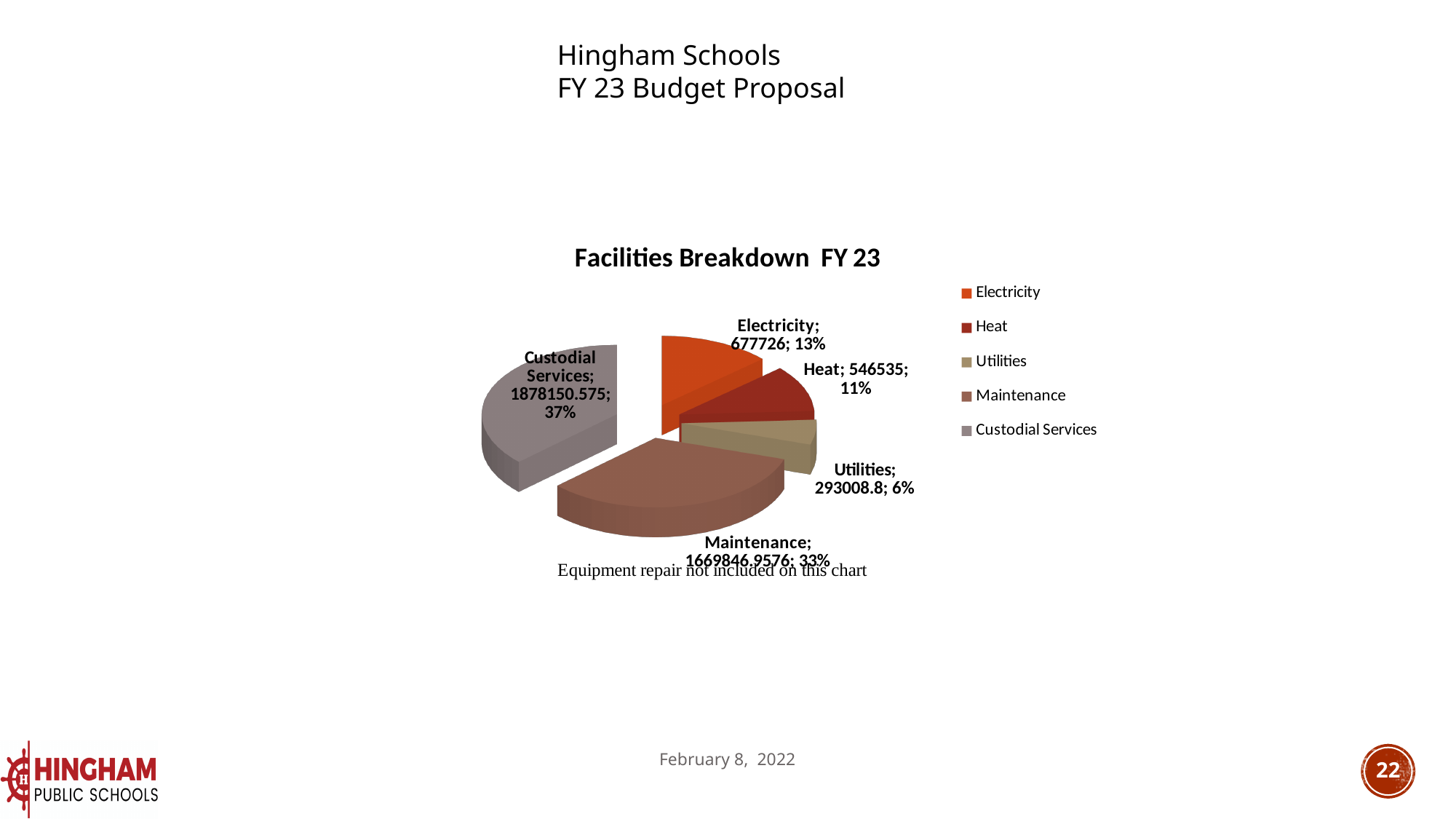
How many entries does the legend list? 5 What is the title of the chart? Facilities Breakdown FY 23 How many slices does the pie chart have? 5 What type of chart is shown on the slide? pie chart What is the value shown for Utilities? 293008.8 What share of the pie does Maintenance represent? 33% Which category has the smallest slice of the pie? Utilities Which is larger, the value for Electricity or the value for Heat? Electricity Which category has the largest slice of the pie? Custodial Services What is the value shown for Electricity? 677726 What is the difference between the values for Electricity and Heat? 131191 What is the value shown for Heat? 546535